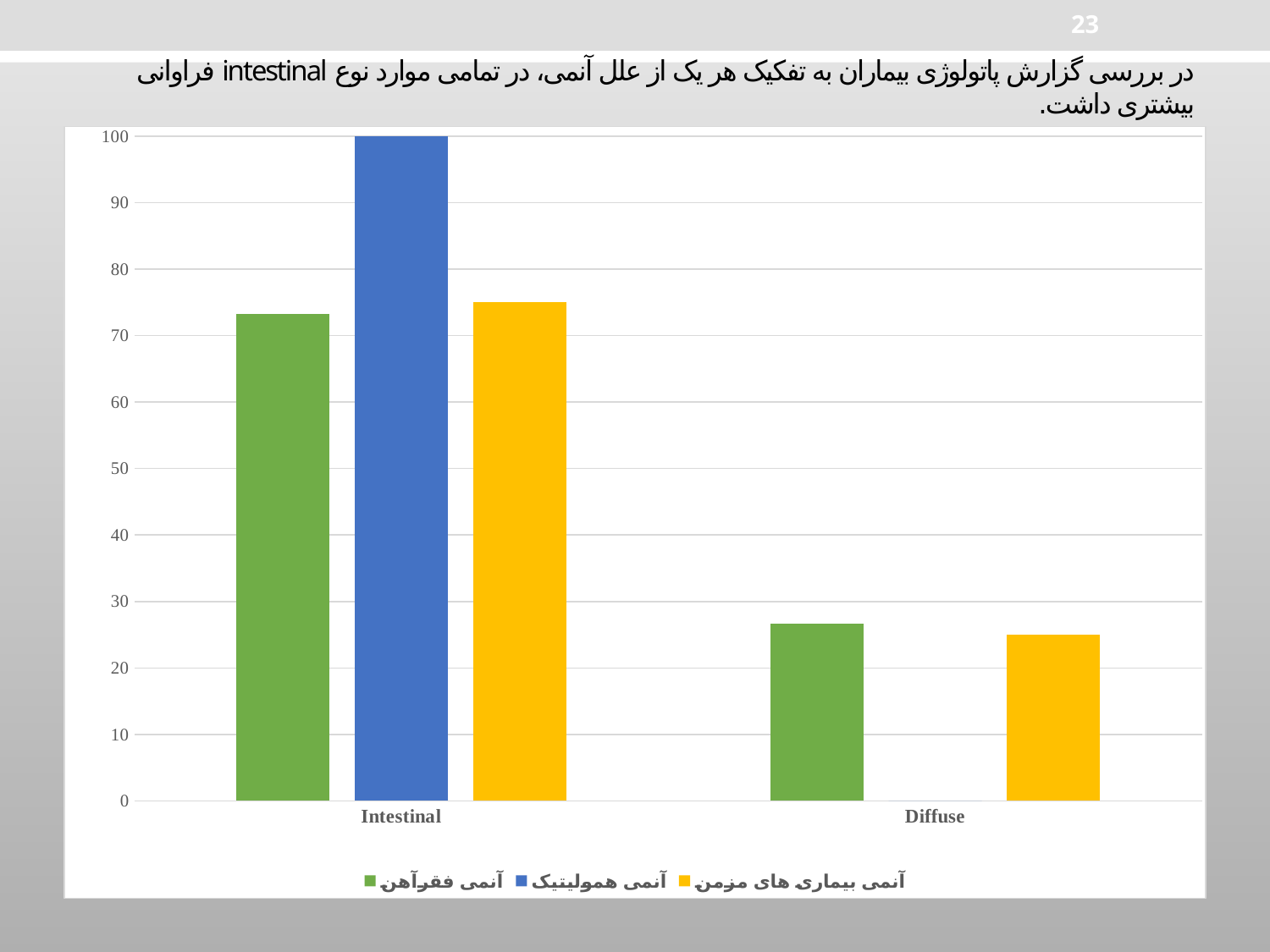
Which is larger in the Intestinal category: the آنمی همولیتیک (blue) bar or the آنمی فقرآهن (yellow) bar? آنمی همولیتیک (blue) Is the value of the آنمی بیماری های مزمن (green) bar for Diffuse greater or less than 20? greater Which series has the highest bar in the Intestinal category? آنمی همولیتیک Is the value of the آنمی بیماری های مزمن (green) bar for Intestinal greater or less than 70? greater Which series in the legend is shown in blue? آنمی همولیتیک Which category, Intestinal or Diffuse, has the tallest bar in the chart? Intestinal Which is larger: the آنمی بیماری های مزمن (green) bar for Intestinal or for Diffuse? Intestinal What kind of chart is shown on the slide? bar chart Is the value of the آنمی فقرآهن (yellow) bar for Diffuse greater or less than 30? less How many categories are shown on the x axis of the chart? 2 How many series does the chart's legend list? 3 What is the value of the آنمی همولیتیک (blue) bar for Intestinal? 100